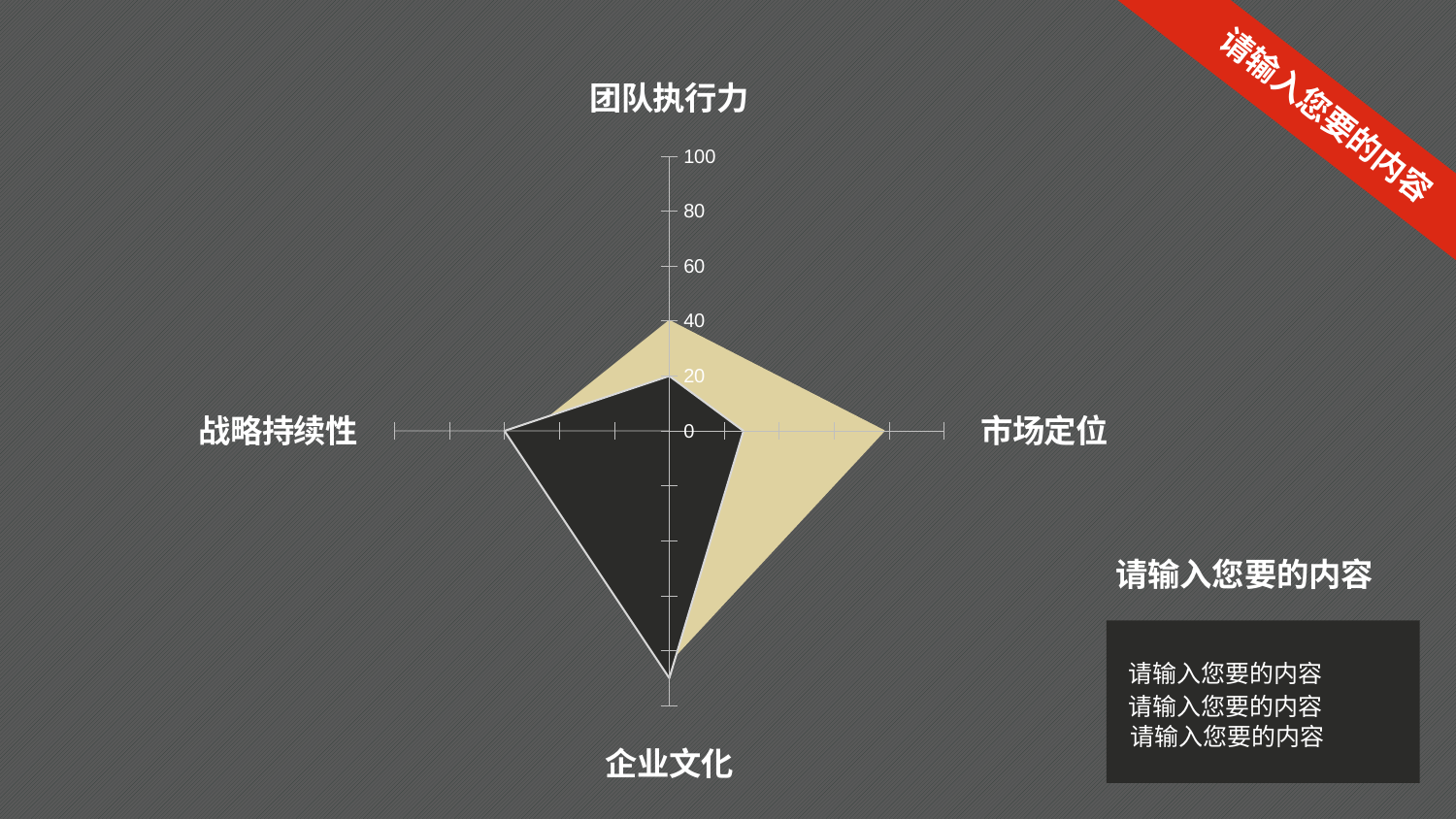
Is the beige series' value for 市场定位 greater or less than 60? greater For 团队执行力, which series has the larger value, the beige one or the dark one? The beige series Is the dark series' value for 市场定位 greater or less than 40? less What kind of chart is shown on the slide? Radar chart How many categories (axes) does the radar chart have? 4 Is the dark series' value for 企业文化 greater or less than 80? greater For the dark series, which category has the highest value? 企业文化 For the beige series, which category has the lowest value? 团队执行力 For 企业文化, which series has the larger value, the beige one or the dark one? The dark series